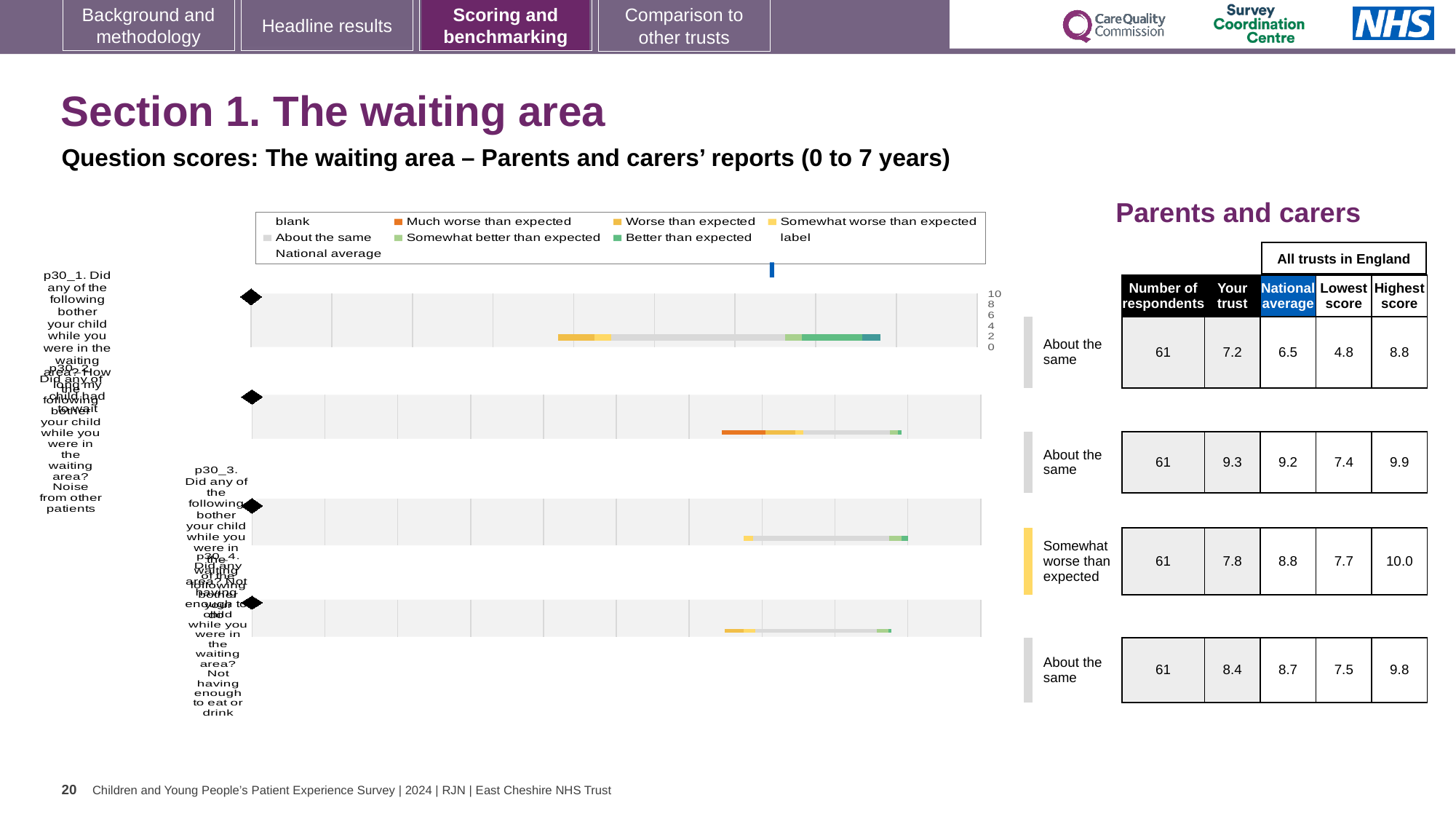
What kind of chart is shown on the slide? bar chart In the table beside the chart, what is the 'Your trust' score for the first question (p30_1)? 7.2 In the table beside the chart, what is the difference between the highest score and the lowest score for p30_1? 4.0 In the table beside the chart, what is the national average for the second question (p30_2)? 9.2 In the table beside the chart, what is the number of respondents for the fourth question (p30_4)? 61 Which question's bar contains an orange 'Much worse than expected' segment? p30_2 In the chart legend, what colour represents 'Much worse than expected'? orange In the chart legend, what colour represents 'Better than expected'? green In the table beside the chart, what is the highest score for the third question (p30_3)? 10.0 How many entries does the chart legend list? 9 How many question bars are plotted in the chart? 4 In the table beside the chart, which is larger for p30_4: the 'Your trust' score or the national average? national average